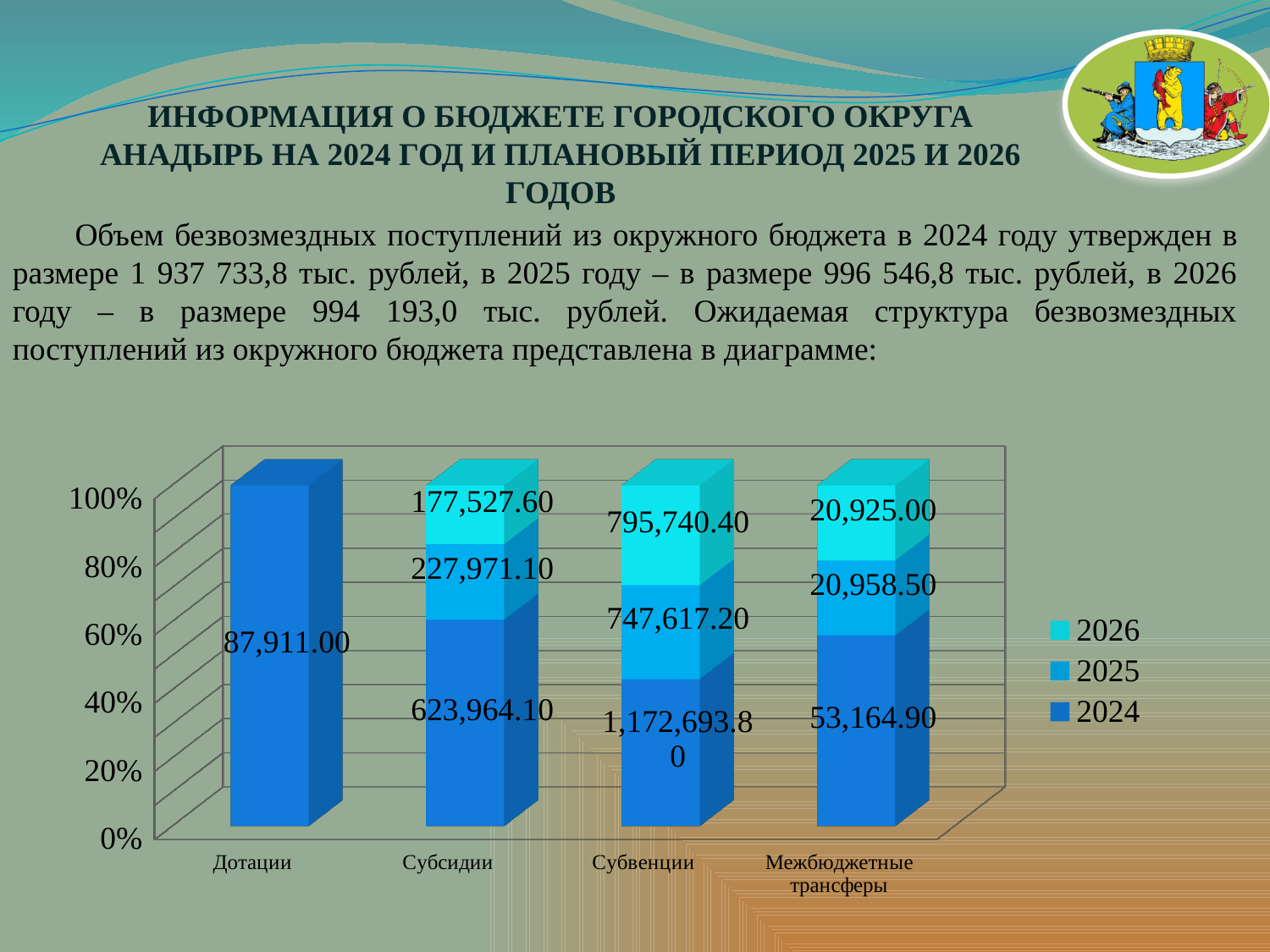
How many series does the legend list? 3 For Субвенции, which is larger: the 2025 value or the 2026 value? 2026 What is the value for Дотации in the 2024 series? 87,911.00 What is the value for Межбюджетные трансферы in the 2026 series? 20,925.00 Which category has the highest value in the 2024 series? Субвенции What kind of chart is shown on the slide? Stacked bar chart What is the value for Субсидии in the 2024 series? 623,964.10 What is the difference between the 2025 and 2026 values for Субсидии? 50,443.50 What is the difference between the 2026 and 2025 values for Субвенции? 48,123.20 Which category has the lowest value in the 2024 series? Межбюджетные трансферы How many categories are shown on the x axis? 4 What is the value for Субвенции in the 2025 series? 747,617.20